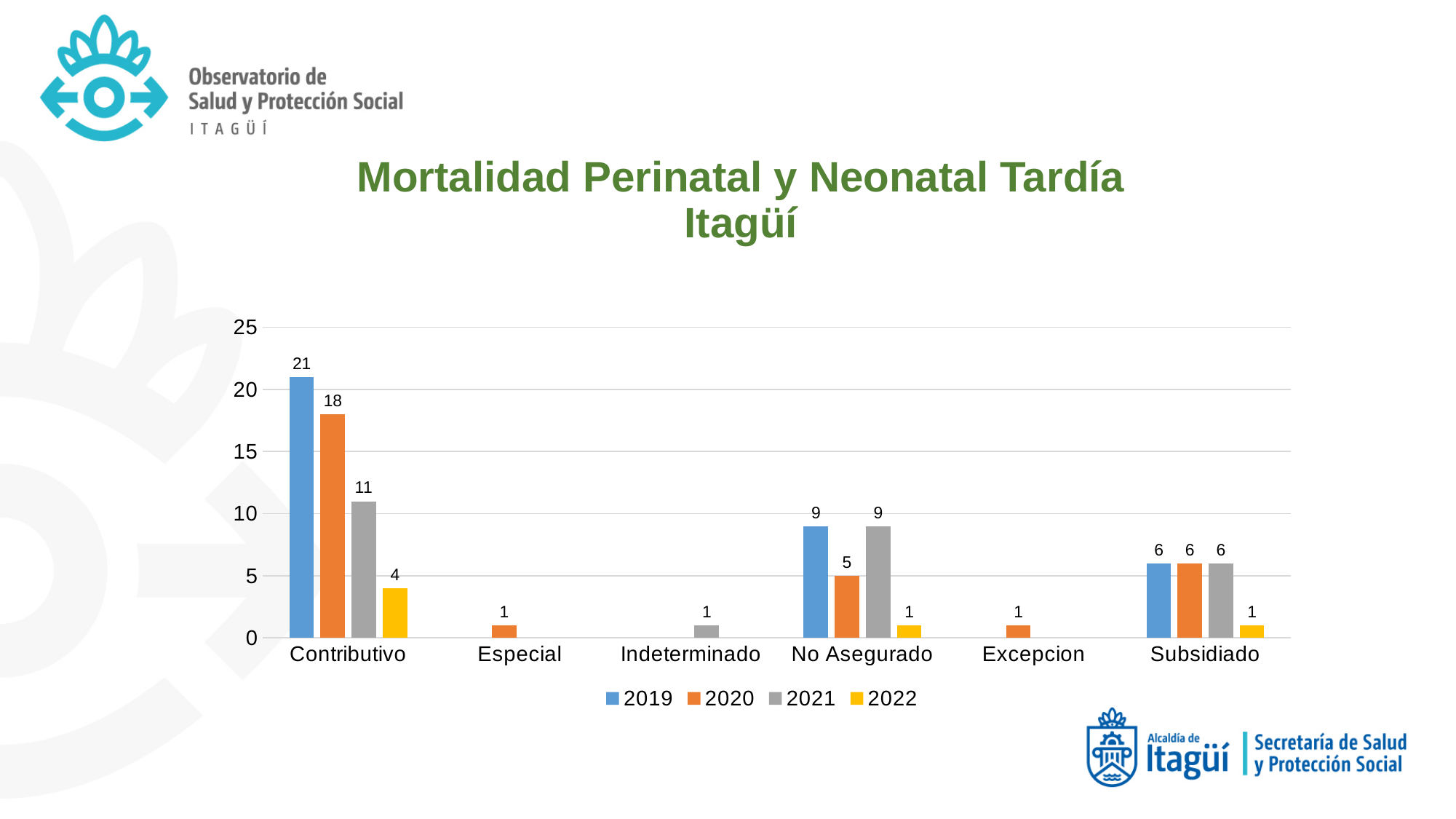
Is the value for Contributivo in 2020 greater or less than 15? greater How many series does the legend list? 4 What is the value for Subsidiado in 2022? 1 What is the value for Contributivo in 2019? 21 What kind of chart is shown on the slide? bar chart Which is larger: the 2021 value for No Asegurado or the 2021 value for Subsidiado? No Asegurado Which category has the lowest value in 2019 among those with a 2019 bar? Subsidiado Which category has the highest value in 2021? Contributivo What is the value for No Asegurado in 2020? 5 How many categories are shown on the x axis? 6 What is the title of the chart? Mortalidad Perinatal y Neonatal Tardía Itagüí What is the difference between the 2019 and 2020 values for Contributivo? 3